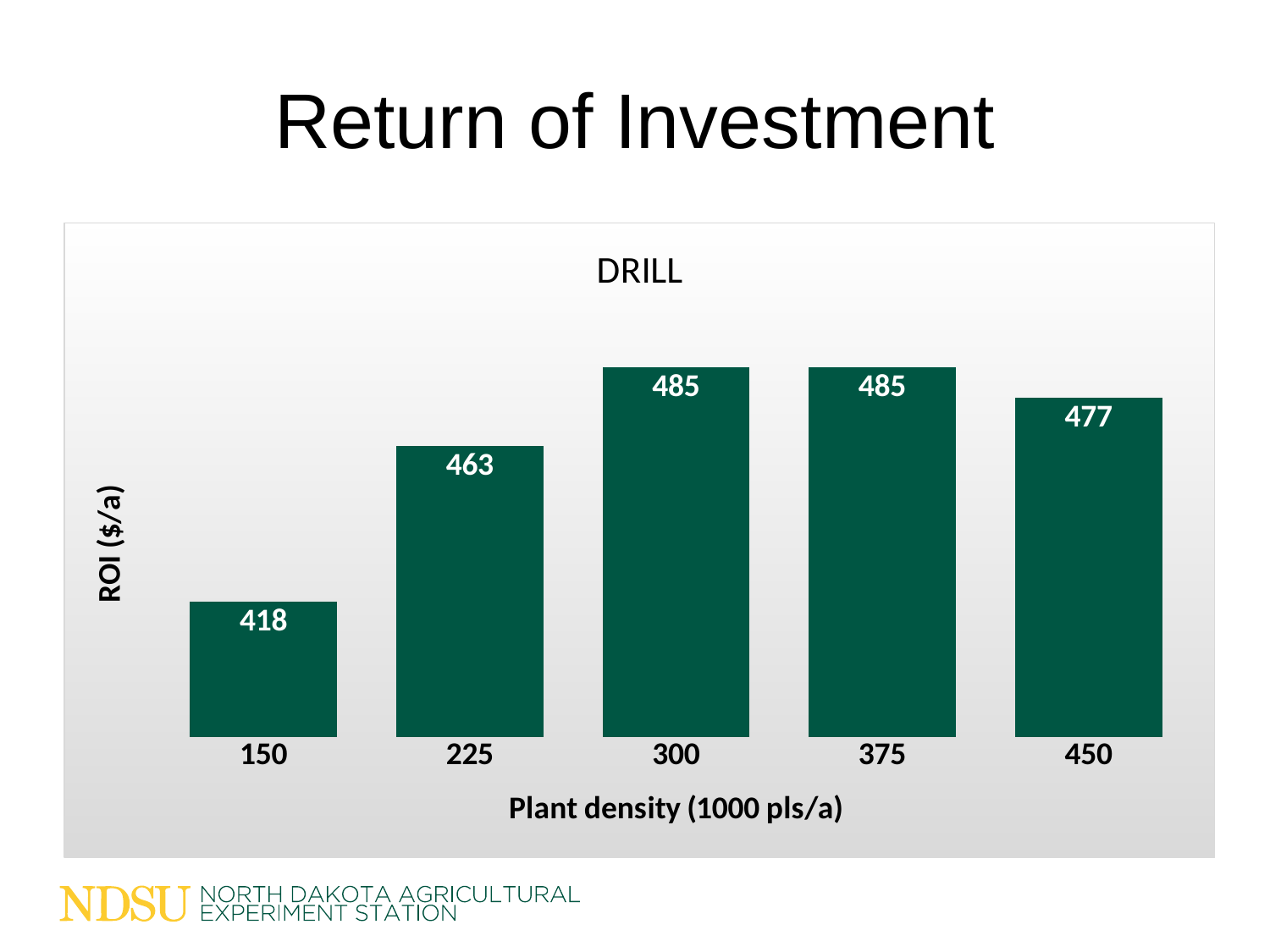
What is the label of the y axis? ROI ($/a) What is the highest ROI value shown on the chart? 485 What is the title shown inside the chart area? DRILL Which has a larger ROI, plant density 225 or plant density 450? 450 What is the difference in ROI between plant densities 300 and 150? 67 How many plant density categories are shown on the chart? 5 What is the ROI for a plant density of 225 (1000 pls/a)? 463 What kind of chart is shown on the slide? Bar chart What is the ROI for a plant density of 150 (1000 pls/a)? 418 What is the difference in ROI between plant densities 375 and 450? 8 Which plant density has the lowest ROI? 150 What is the ROI for a plant density of 450 (1000 pls/a)? 477